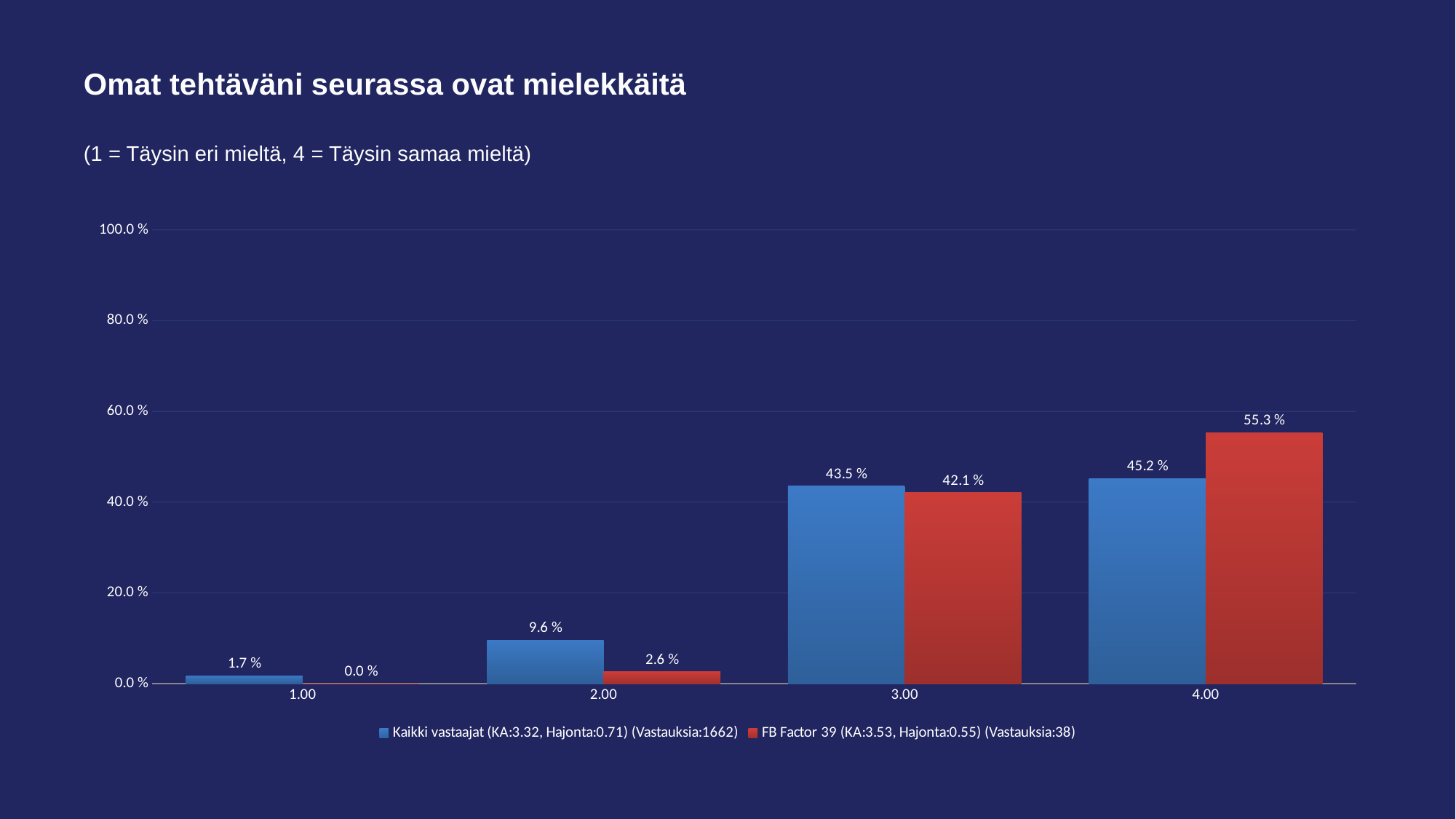
How many series does the legend list? 2 Which category has the highest value for FB Factor 39? 4.00 Which category has the lowest value for Kaikki vastaajat? 1.00 How many categories are shown on the x axis? 4 What is the value for FB Factor 39 at category 1.00? 0.0 % What is the value for Kaikki vastaajat at category 3.00? 43.5 % What is the difference between the FB Factor 39 and Kaikki vastaajat values at category 4.00? 10.1 % What kind of chart is shown on the slide? Bar chart What is the value for FB Factor 39 at category 4.00? 55.3 % What is the value for Kaikki vastaajat at category 2.00? 9.6 % What colour are the bars for the FB Factor 39 series? Red At category 3.00, which series has the larger value, Kaikki vastaajat or FB Factor 39? Kaikki vastaajat